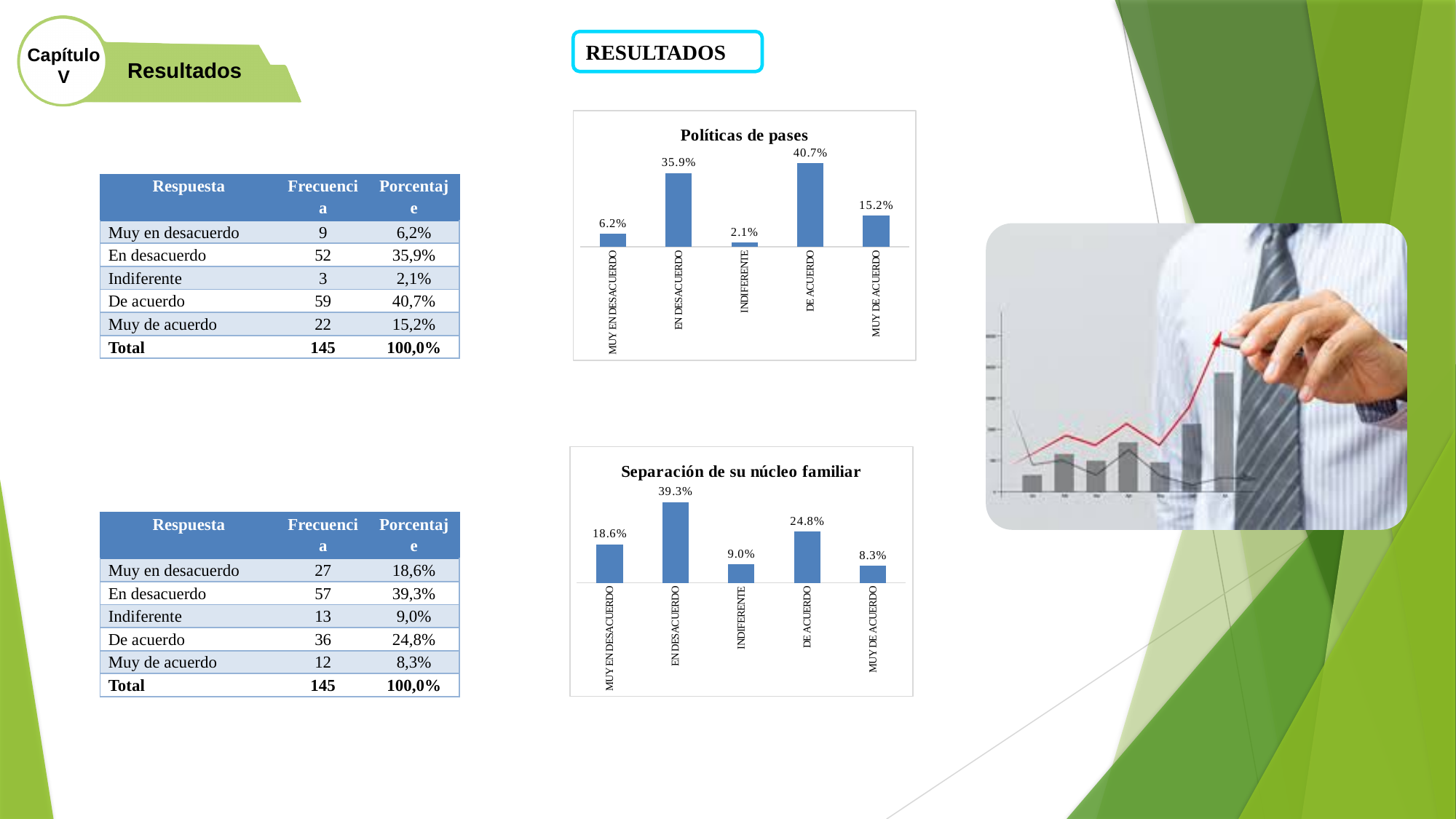
In the 'Separación de su núcleo familiar' chart, what is the value for MUY EN DESACUERDO? 18.6% In the 'Políticas de pases' chart, how many categories are shown? 5 In the 'Políticas de pases' chart, what is the difference between DE ACUERDO and EN DESACUERDO? 4.8% In the 'Políticas de pases' chart, what is the value for DE ACUERDO? 40.7% What type of chart is 'Políticas de pases'? Bar chart What is the title of the lower chart on the slide? Separación de su núcleo familiar In the 'Separación de su núcleo familiar' chart, which category has the lowest value? MUY DE ACUERDO In the 'Políticas de pases' chart, which category has the highest value? DE ACUERDO In the 'Separación de su núcleo familiar' chart, what is the difference between EN DESACUERDO and DE ACUERDO? 14.5% In the 'Políticas de pases' chart, which category has the lowest value? INDIFERENTE In the 'Separación de su núcleo familiar' chart, which category has the highest value? EN DESACUERDO In the 'Separación de su núcleo familiar' chart, which is larger: INDIFERENTE or MUY DE ACUERDO? INDIFERENTE